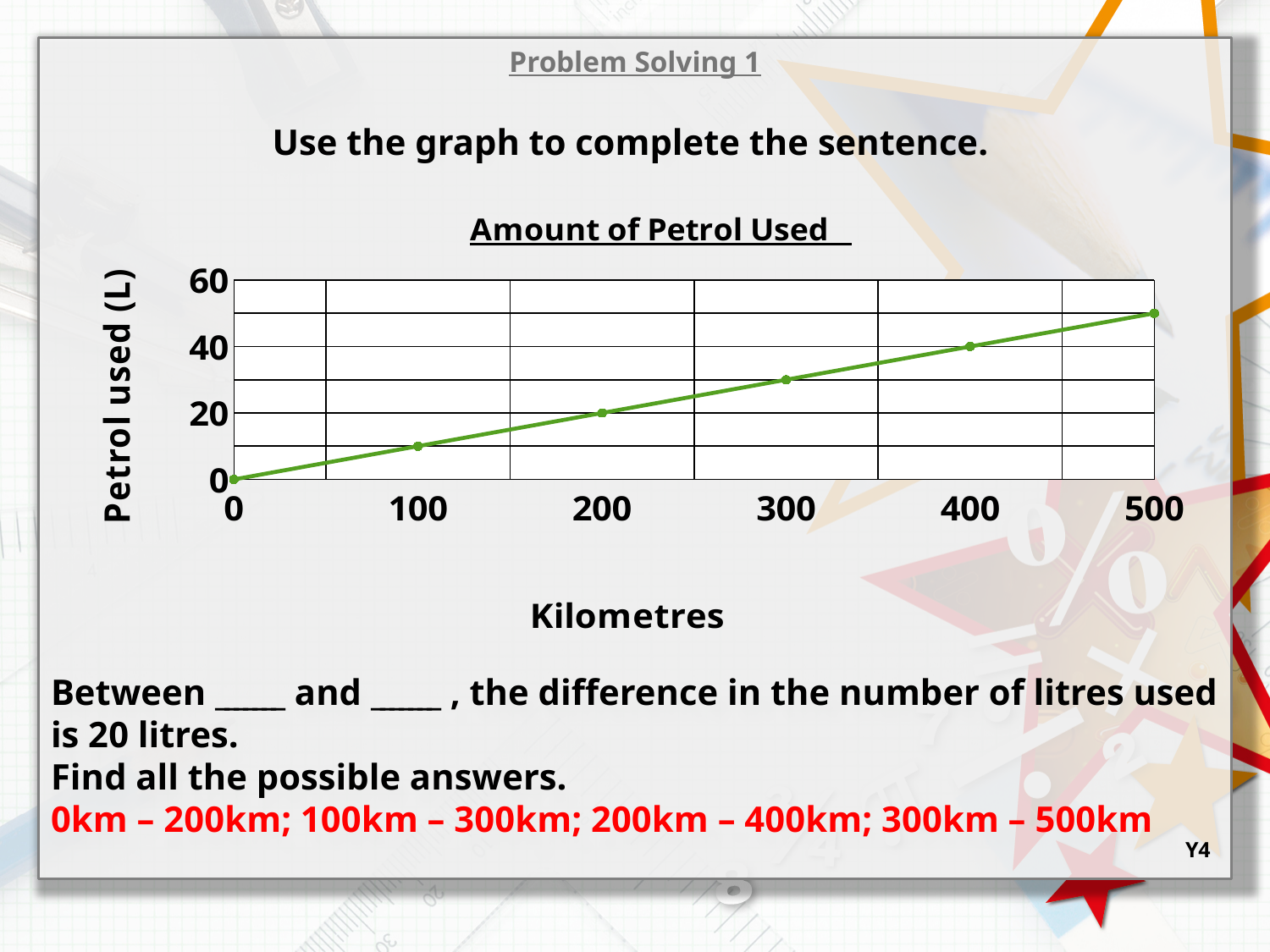
Is the petrol used at 100 kilometres greater or less than 20? less How many litres of petrol were used at 200 kilometres? 20 How many litres of petrol were used at 400 kilometres? 40 Is the petrol used at 500 kilometres greater or less than 40? greater Which is larger, the petrol used at 400 kilometres or at 200 kilometres? 400 kilometres What type of chart is shown on the slide? line chart What is the title of the chart? Amount of Petrol Used How many data points are plotted on the line? 6 Does the petrol used rise or fall as the kilometres increase? rise What is the label of the y axis? Petrol used (L) At which distance is the petrol used highest? 500 kilometres What is the difference in petrol used between 200 kilometres and 400 kilometres? 20